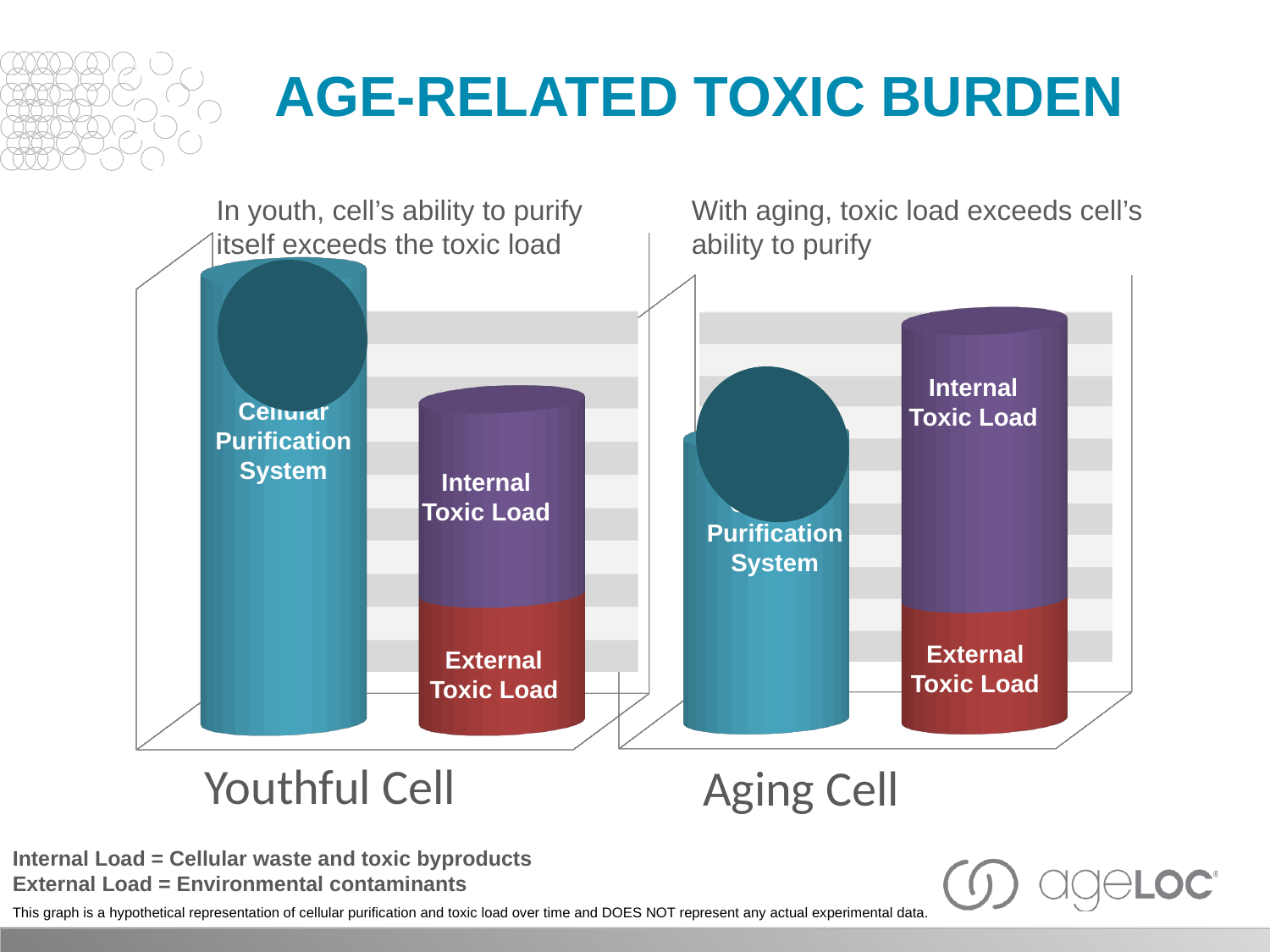
What is the title of the slide containing the two charts? AGE-RELATED TOXIC BURDEN Which chart has the taller Cellular Purification System bar: Youthful Cell or Aging Cell? Youthful Cell In the Youthful Cell chart, which bar is taller: Cellular Purification System or the stacked toxic load bar? Cellular Purification System What kind of chart is shown for the Aging Cell? bar chart What colour is the External Toxic Load segment in the charts? red In the Youthful Cell chart, which segment of the stacked bar is larger: Internal Toxic Load or External Toxic Load? Internal Toxic Load What kind of chart is shown for the Youthful Cell? bar chart How many segments make up the stacked toxic load bar in the Aging Cell chart? 2 How many bars are shown in the Youthful Cell chart? 2